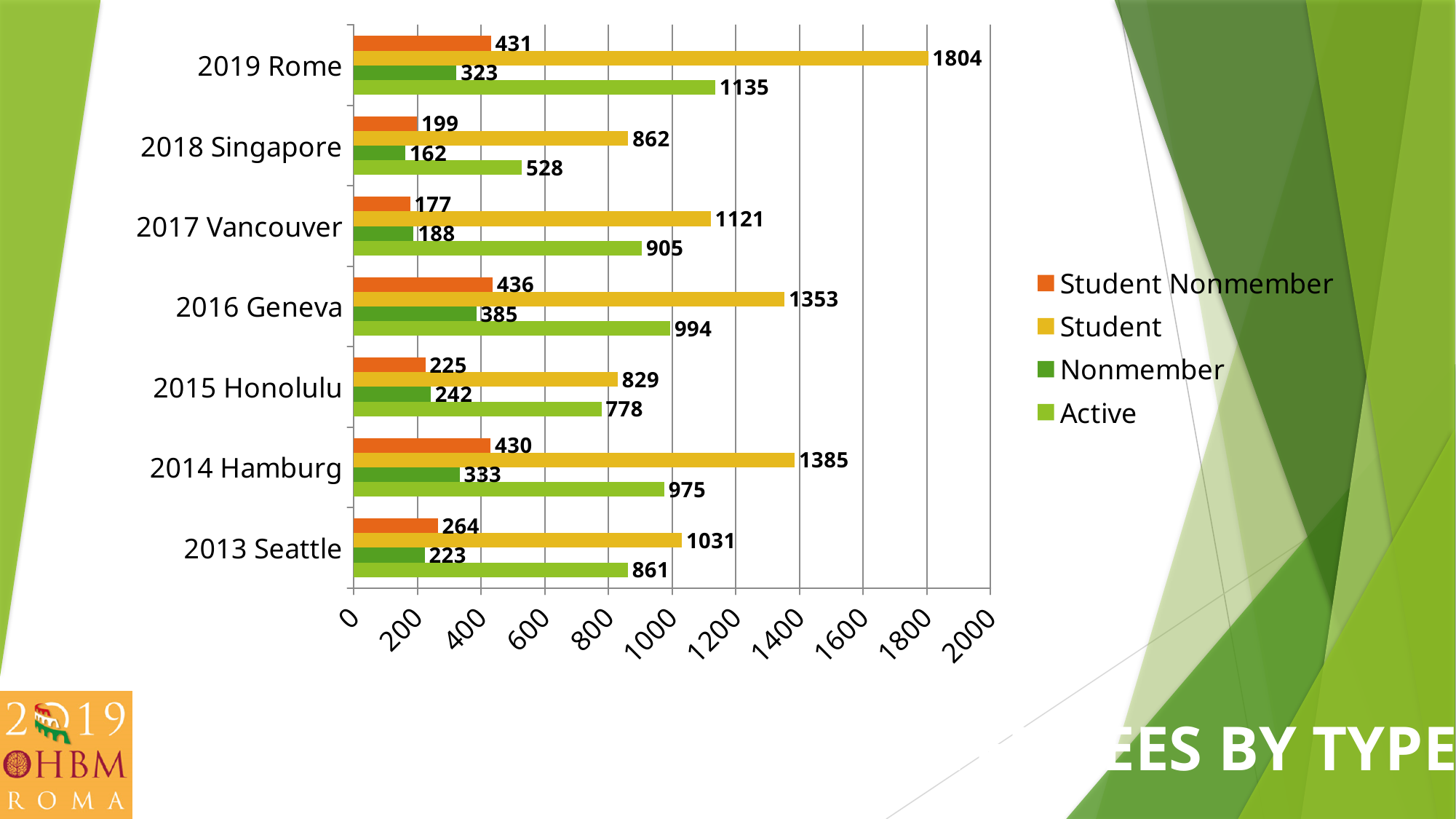
What is the Student Nonmember value for 2016 Geneva? 436 How many meetings (categories) are shown on the chart? 7 Which series is shown in orange in the legend? Student Nonmember What is the difference between the Student values for 2014 Hamburg and 2013 Seattle? 354 How many series does the legend list? 4 Which meeting has the lowest Active value? 2018 Singapore What kind of chart is shown on the slide? bar chart What is the Student value for 2019 Rome? 1804 Which is larger, the Active value for 2017 Vancouver or for 2016 Geneva? 2016 Geneva Which meeting has the highest Student value? 2019 Rome What is the Active value for 2015 Honolulu? 778 What is the Nonmember value for 2018 Singapore? 162